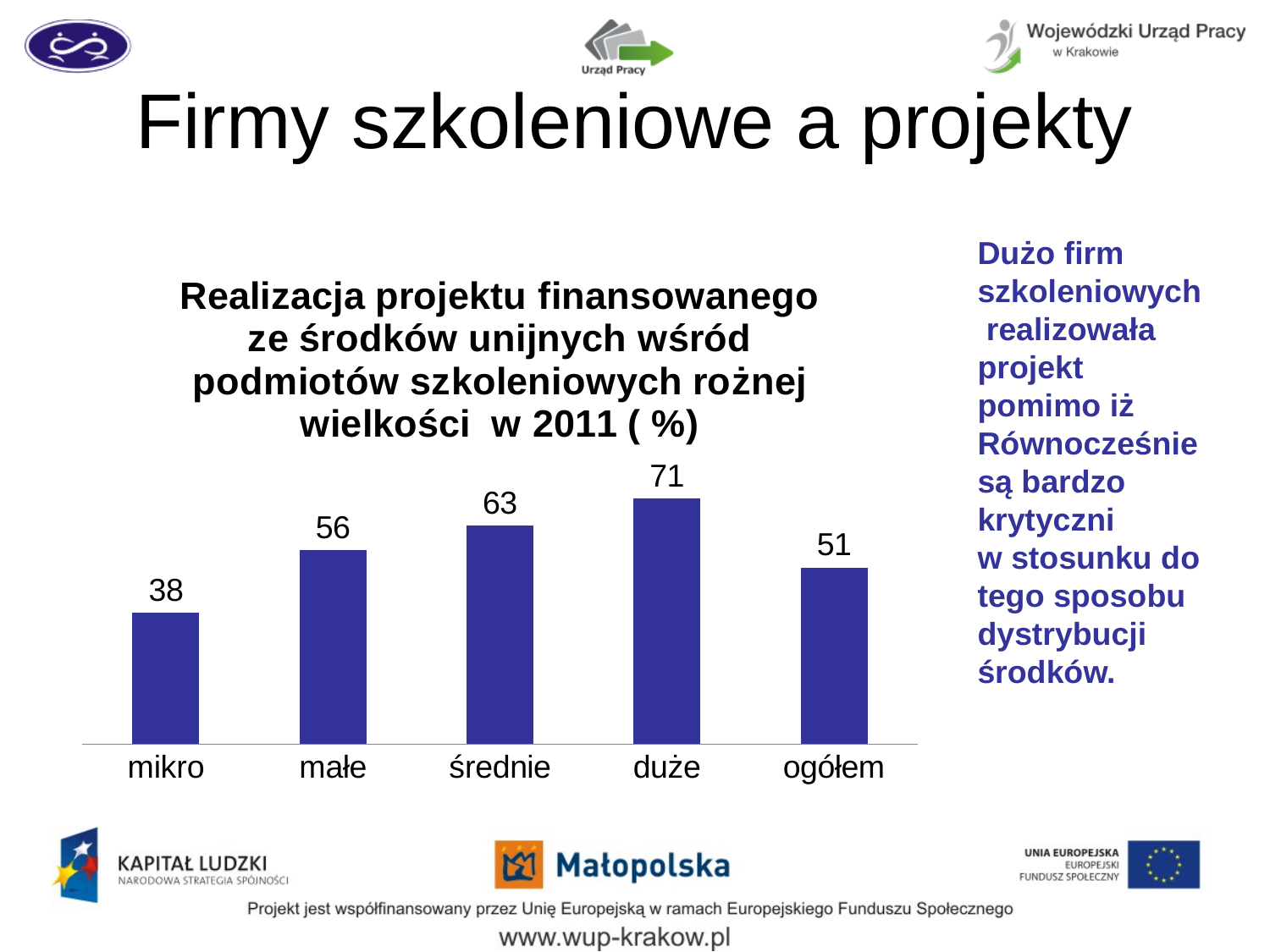
Which category has the lowest value? mikro What year does the chart title refer to? 2011 Which category has the highest value? duże What is the value for duże? 71 How many categories are shown on the x axis? 5 What kind of chart is shown on the slide? bar chart What is the difference between the values for duże and mikro? 33 Which is larger, the value for małe or the value for ogółem? małe Do the values rise or fall from mikro to duże? rise What is the difference between the values for średnie and małe? 7 What is the value for ogółem? 51 What is the value for mikro? 38